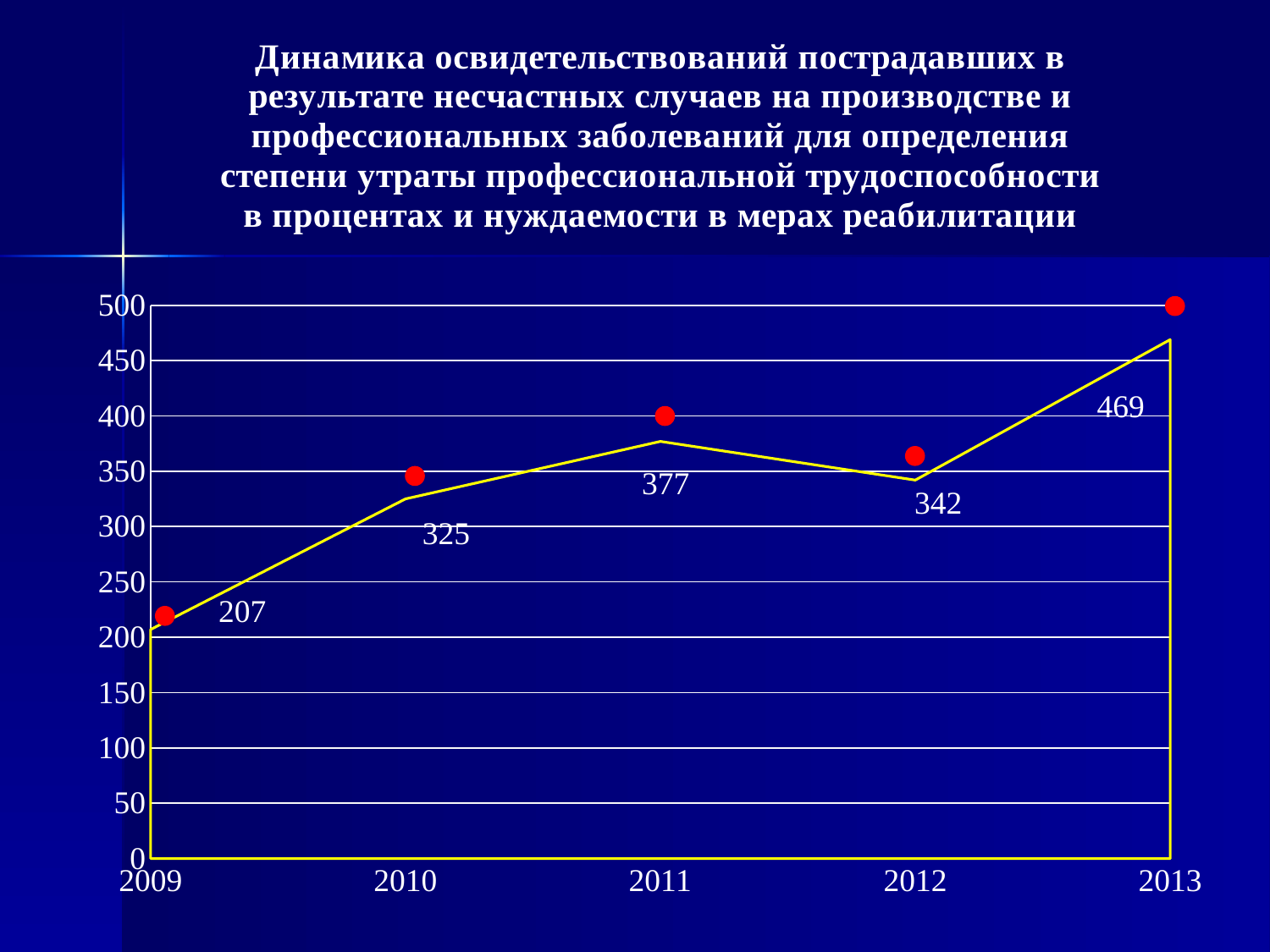
Which year has the lowest value? 2009 Which year has the highest value? 2013 What is the value for 2009? 207 What is the difference between the values for 2013 and 2012? 127 Is the value for 2012 greater or less than 300? greater Which is larger, the value for 2011 or the value for 2012? 2011 How many years are plotted on the chart? 5 Does the value rise or fall from 2011 to 2012? fall What is the value for 2013? 469 What is the difference between the values for 2010 and 2009? 118 What kind of chart is shown on the slide? line chart What is the value for 2011? 377